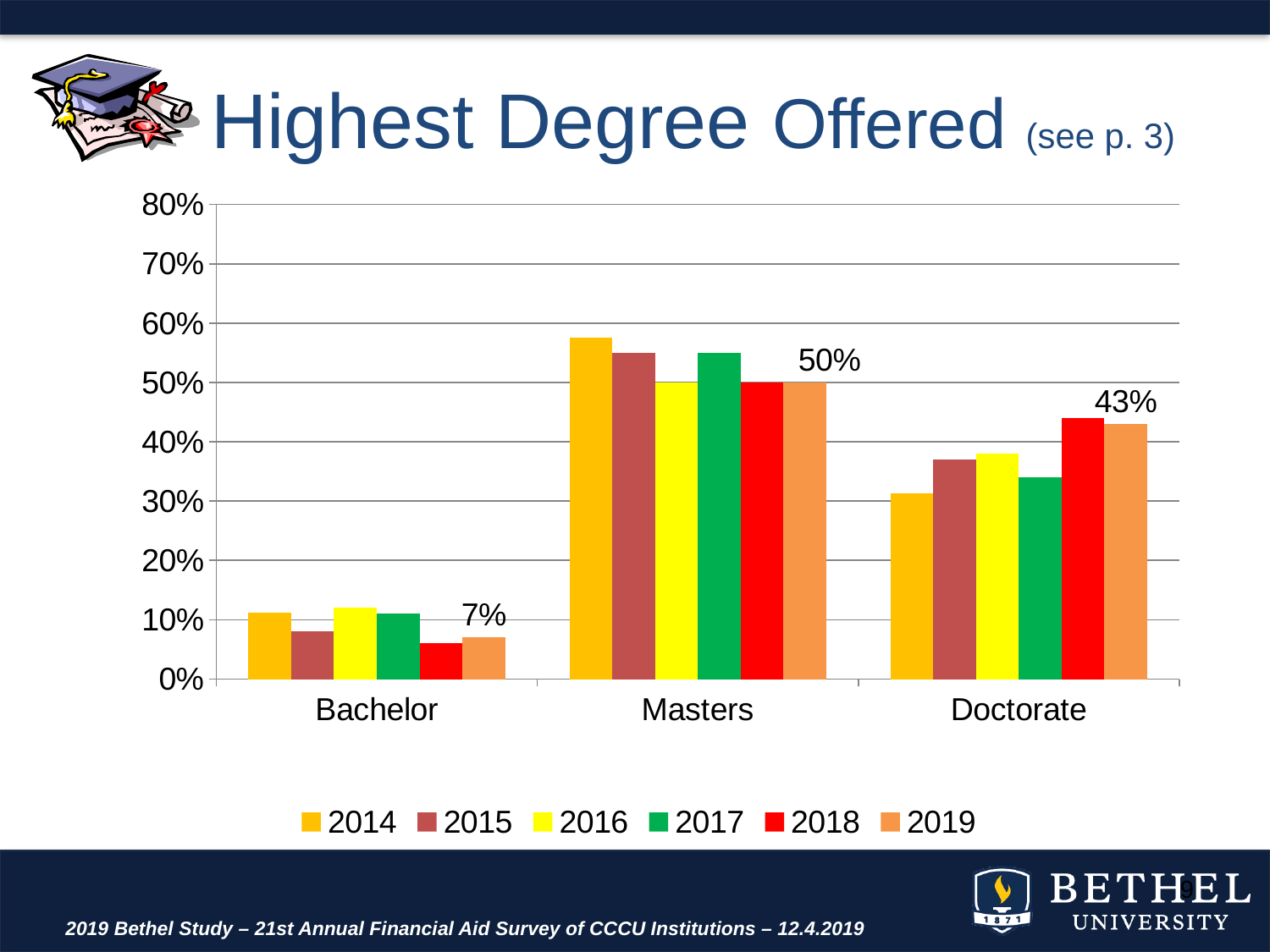
How many series does the legend list? 6 How many degree categories are shown on the x axis? 3 Which is larger: the 2018 value for Doctorate or the 2017 value for Doctorate? 2018 What kind of chart is shown on the slide? Bar chart What is the value for Doctorate in 2019? 43% Is the value for Doctorate in 2017 greater or less than 40%? less What is the value for Masters in 2019? 50% What is the difference between the 2019 values for Masters and Doctorate? 7% Among the 2019 values, which degree category has the highest value? Masters Is the value for Masters in 2014 greater or less than 50%? greater Among the 2019 values, which degree category has the lowest value? Bachelor What is the value for Bachelor in 2019? 7%